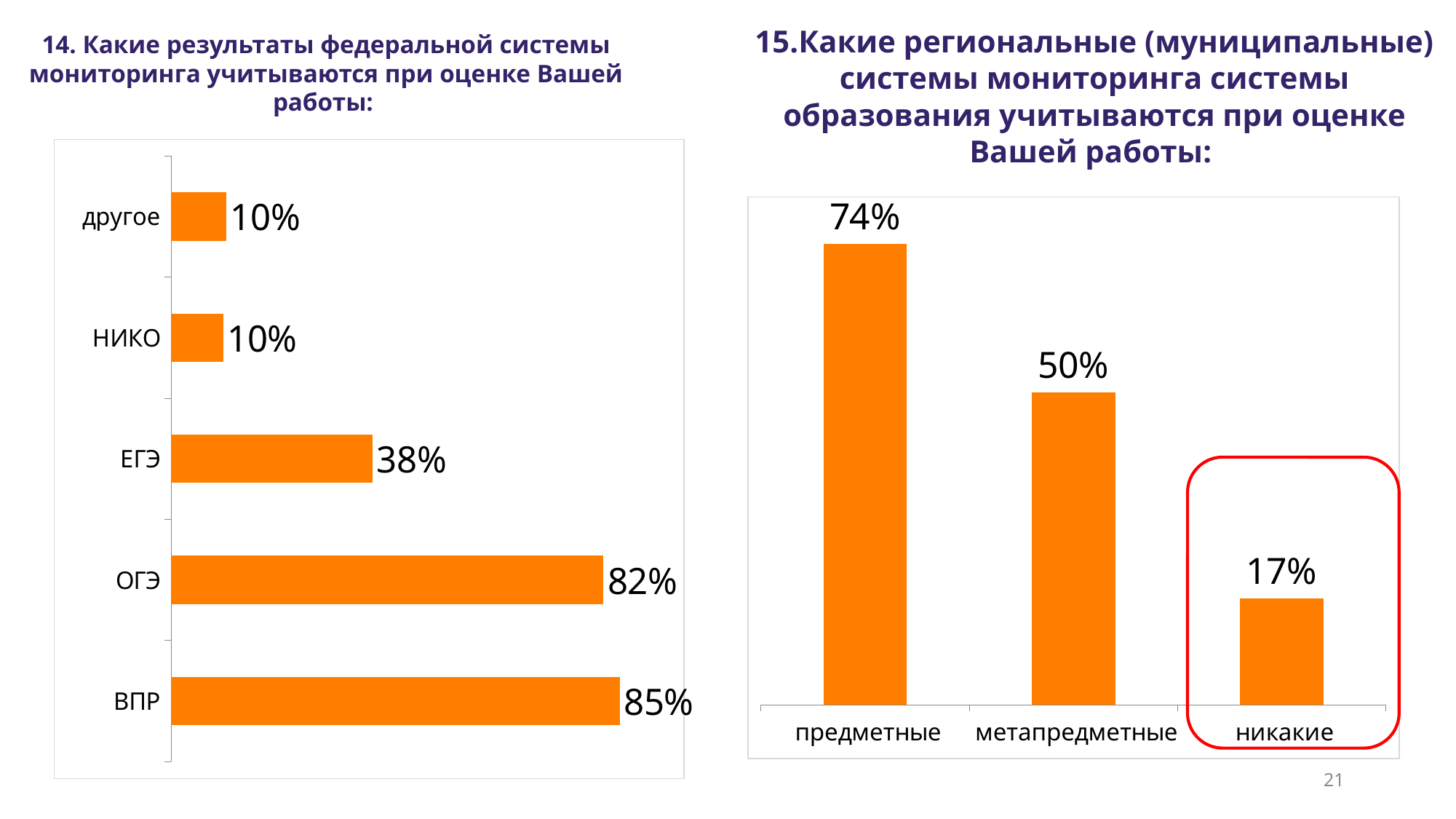
In the right chart (question 15), how many categories are shown? 3 In the left chart (question 14), what is the value for ВПР? 85% In the right chart (question 15), what is the value for метапредметные? 50% In the right chart (question 15), which category has the lowest value? никакие In the right chart (question 15), what is the difference between the values for предметные and никакие? 57% In the left chart (question 14), what is the difference between the values for ОГЭ and ЕГЭ? 44% In the left chart (question 14), what kind of chart is shown? bar chart In the right chart (question 15), which category is highlighted with a red outline? никакие In the left chart (question 14), which is larger, the value for ОГЭ or the value for ЕГЭ? ОГЭ In the left chart (question 14), which category has the highest value? ВПР In the left chart (question 14), how many categories are shown? 5 In the left chart (question 14), what is the value for ЕГЭ? 38%